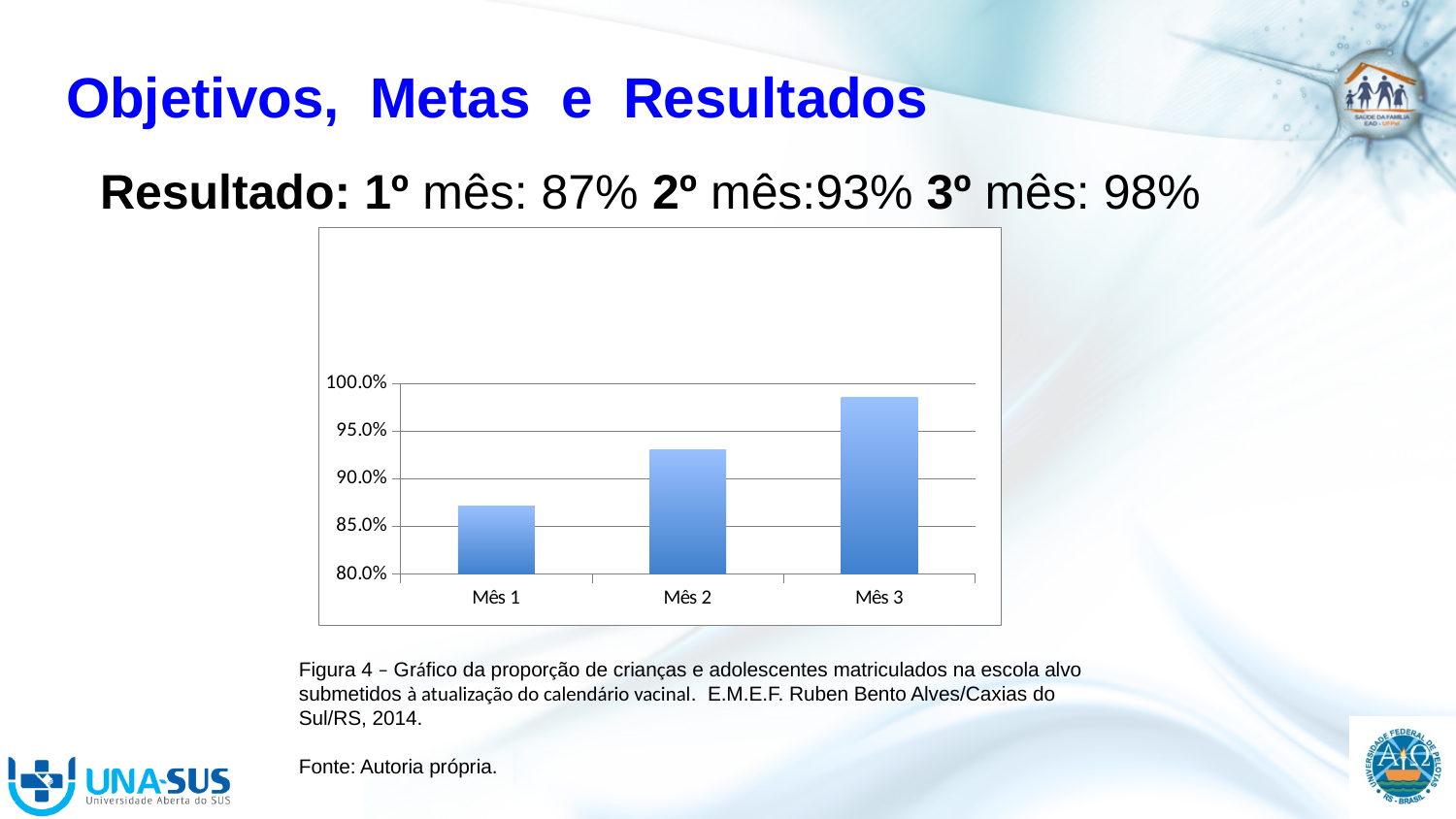
Is the value for Mês 2 greater or less than 90.0%? greater Is the value for Mês 1 greater or less than 90.0%? less What is the lowest value shown on the chart's vertical axis? 80.0% According to the result text on the slide, what is the proportion for the 3º mês? 98% Is the value for Mês 3 greater or less than 95.0%? greater Which month has the highest bar in the chart? Mês 3 How many bars (categories) does the chart show? 3 Do the values rise or fall from Mês 1 to Mês 3? rise Which is larger, the value for Mês 2 or the value for Mês 1? Mês 2 What kind of chart is shown on the slide? bar chart According to the result text on the slide, what is the proportion for the 1º mês? 87% Which month has the lowest bar in the chart? Mês 1